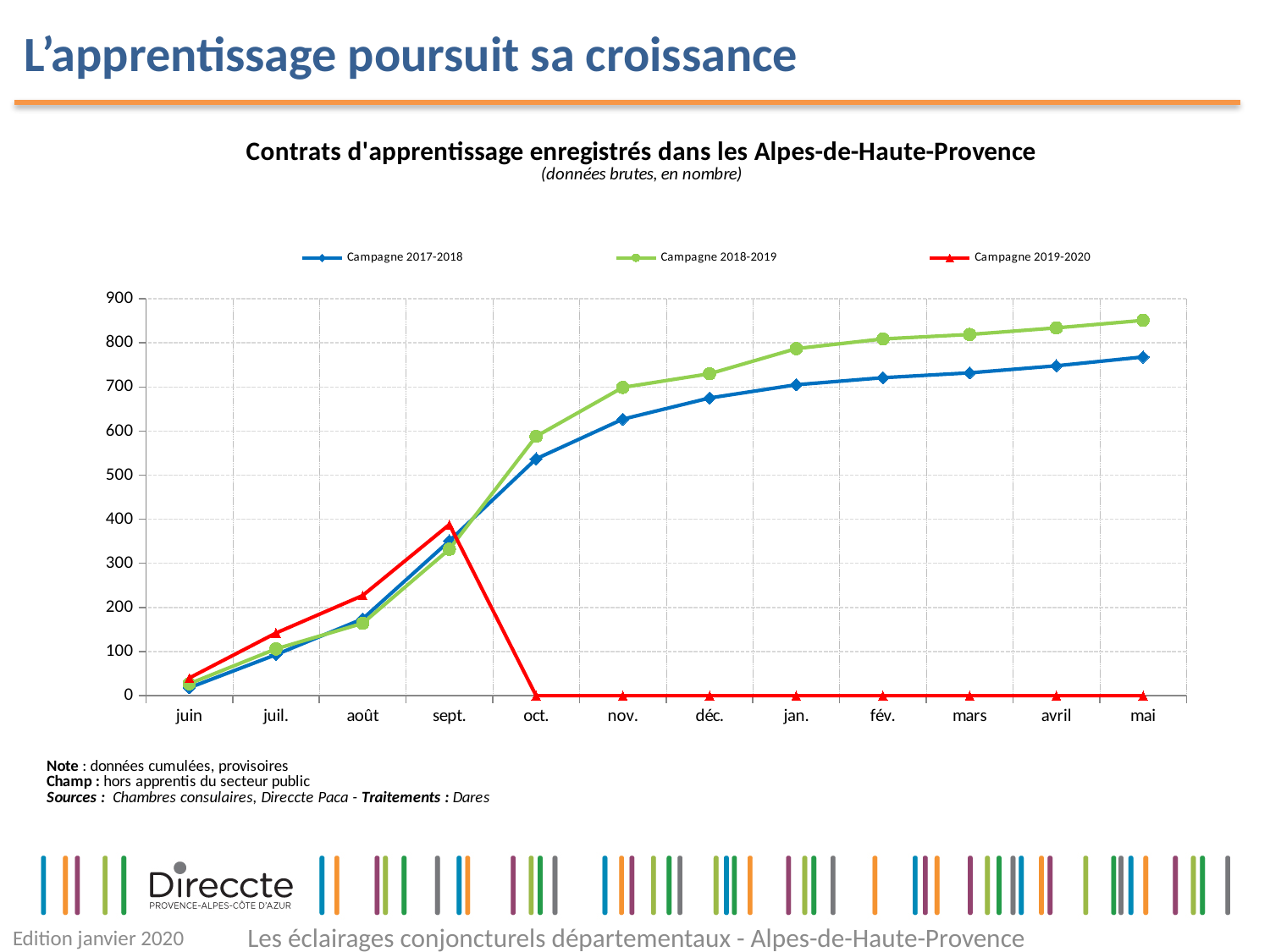
How many series does the legend list? 3 What is the title of the chart? Contrats d'apprentissage enregistrés dans les Alpes-de-Haute-Provence How many months are shown along the x axis? 12 Is the value for Campagne 2017-2018 in mai greater or less than 800? less In sept., which series has the higher value: Campagne 2019-2020 or Campagne 2018-2019? Campagne 2019-2020 Which series is drawn in red? Campagne 2019-2020 Is the value for Campagne 2018-2019 in mai greater or less than 800? greater Is the value for Campagne 2019-2020 in août greater or less than 200? greater What kind of chart is shown on the slide? line chart In mai, which series has the higher value: Campagne 2017-2018 or Campagne 2018-2019? Campagne 2018-2019 Does the Campagne 2018-2019 series rise or fall from juin to mai? rise